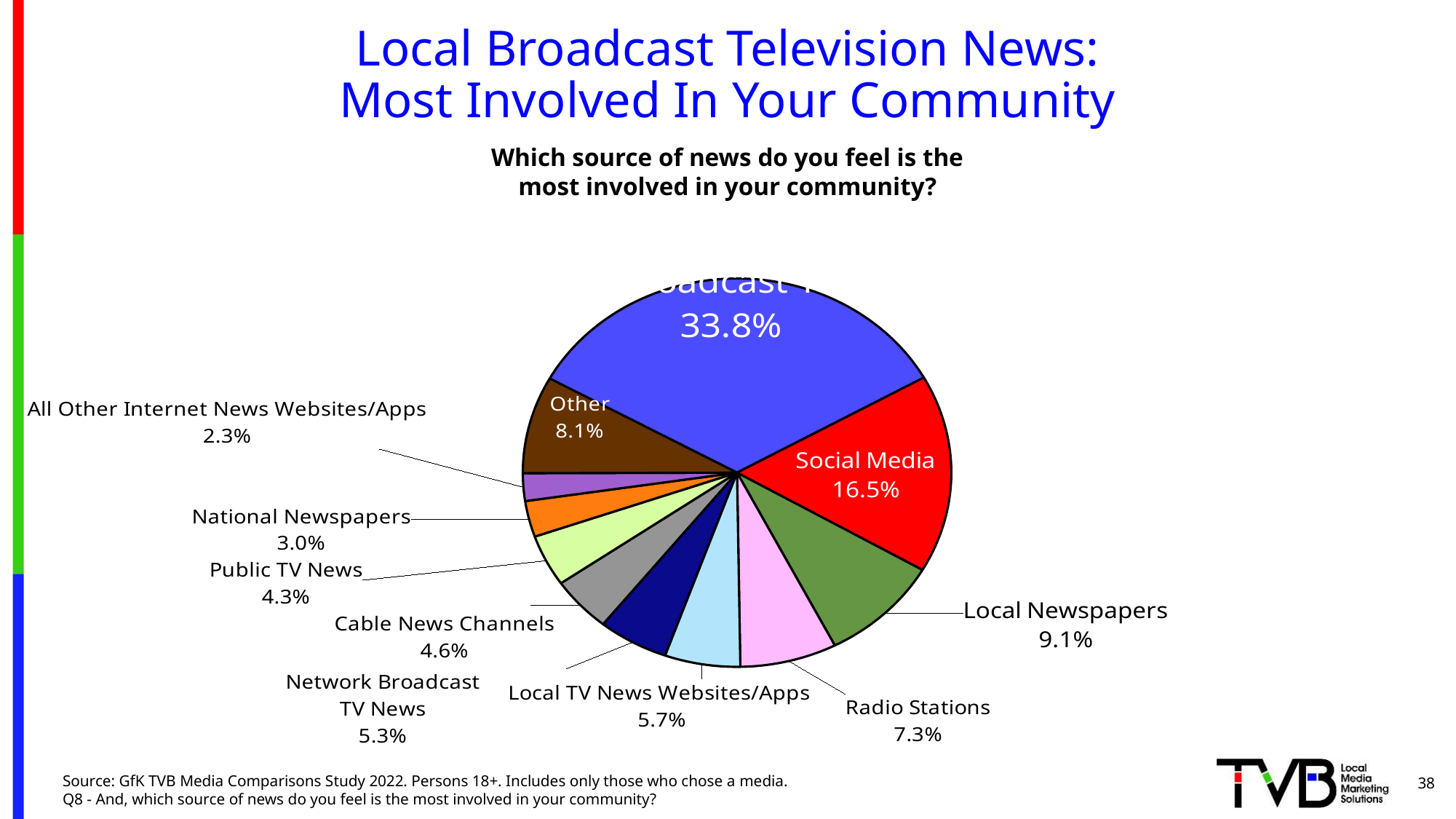
How many slices does the pie chart have? 11 What is the value for Network Broadcast TV News? 5.3% What is the value shown for Local Newspapers? 9.1% What percentage is shown for Radio Stations? 7.3% What is the percentage shown on the largest slice of the pie? 33.8% What is the difference in percentage points between Social Media and Local Newspapers? 7.4 Which category has the smallest slice of the pie? All Other Internet News Websites/Apps What percentage is shown for the Other slice? 8.1% What is the difference in percentage points between Radio Stations and Local TV News Websites/Apps? 1.6 What type of chart is shown on the slide? pie chart What percentage of respondents chose Social Media as the news source most involved in their community? 16.5% Which is larger, Cable News Channels or Public TV News? Cable News Channels